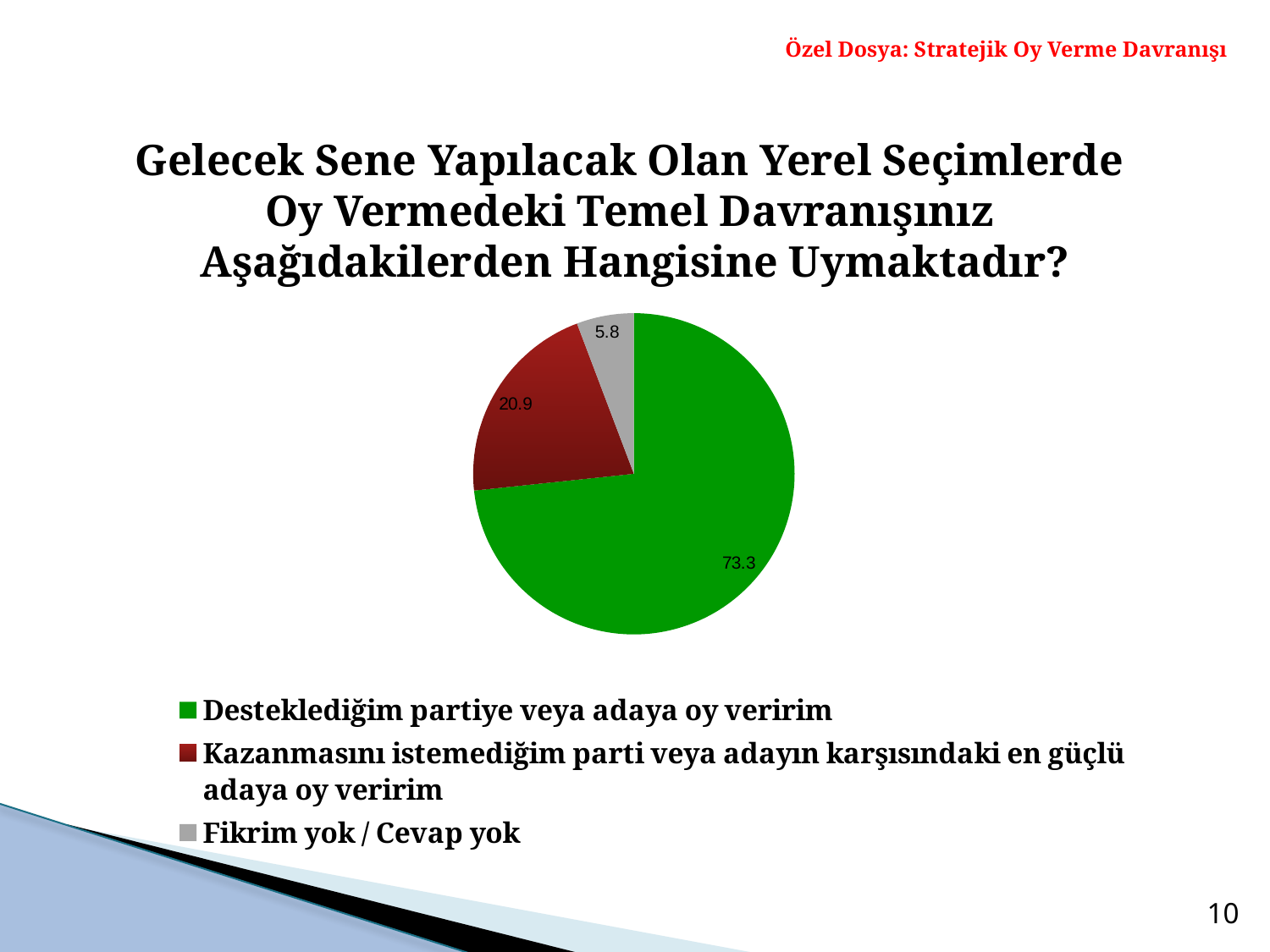
What is the value for "Desteklediğim partiye veya adaya oy veririm"? 73.3 What is the value for "Fikrim yok / Cevap yok"? 5.8 What is the value for "Kazanmasını istemediğim parti veya adayın karşısındaki en güçlü adaya oy veririm"? 20.9 What colour is the slice for "Fikrim yok / Cevap yok"? grey What is the difference between the values for "Desteklediğim partiye veya adaya oy veririm" and "Kazanmasını istemediğim parti veya adayın karşısındaki en güçlü adaya oy veririm"? 52.4 Which category has the largest slice of the pie? Desteklediğim partiye veya adaya oy veririm What colour is the slice for "Desteklediğim partiye veya adaya oy veririm"? green How many slices does the pie chart have? 3 What kind of chart is shown on the slide? pie chart Which is larger: the value for "Kazanmasını istemediğim parti veya adayın karşısındaki en güçlü adaya oy veririm" or the value for "Fikrim yok / Cevap yok"? Kazanmasını istemediğim parti veya adayın karşısındaki en güçlü adaya oy veririm What is the difference between the values for "Kazanmasını istemediğim parti veya adayın karşısındaki en güçlü adaya oy veririm" and "Fikrim yok / Cevap yok"? 15.1 Which category has the smallest slice of the pie? Fikrim yok / Cevap yok